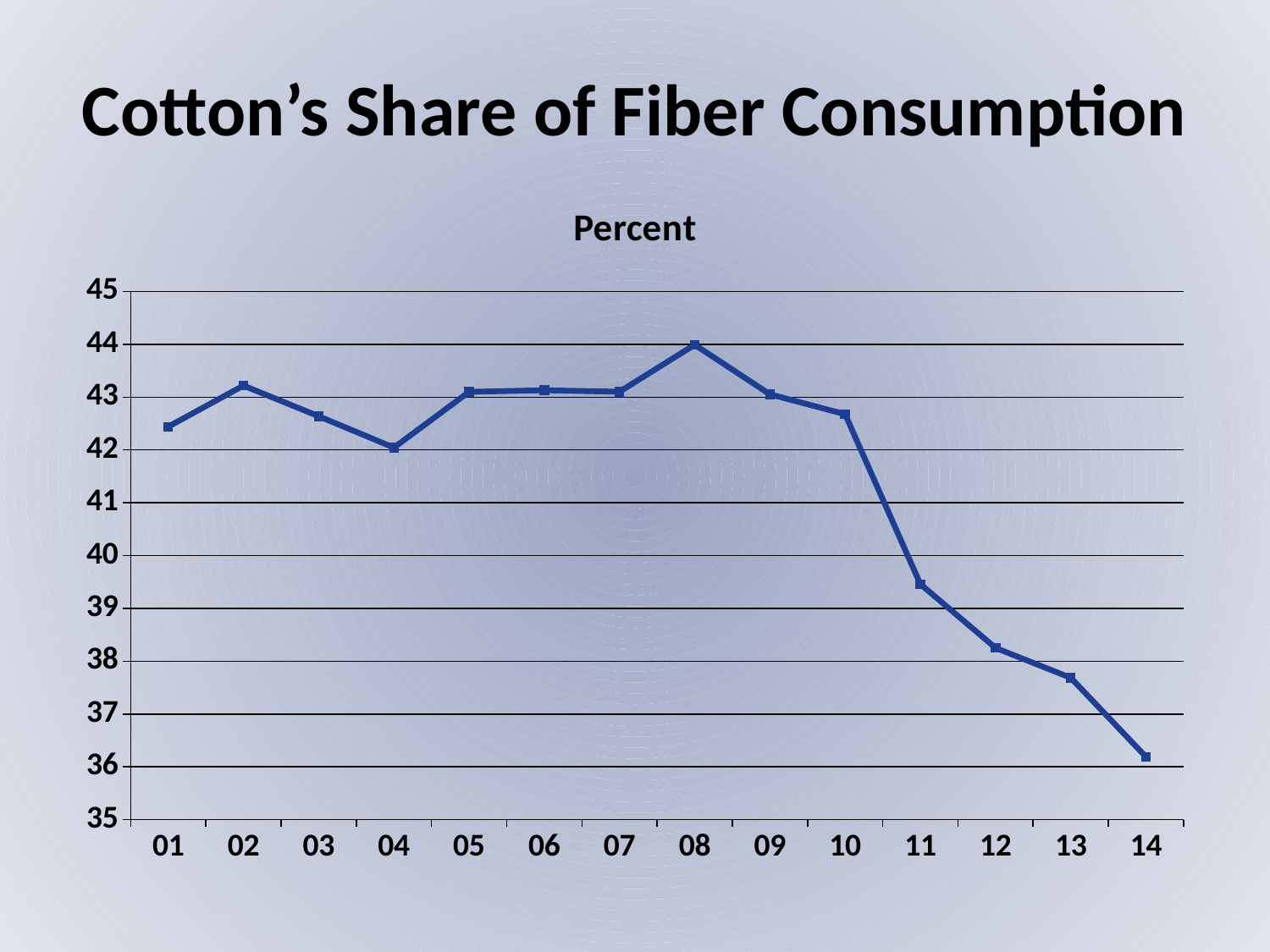
Which year has the larger value, 11 or 12? 11 Do the values rise or fall from 10 to 14? fall What unit label appears above the chart? Percent What kind of chart is shown on the slide? line chart Is the value for 04 greater or less than 41? greater How many years are plotted along the x axis? 14 Is the value for 08 greater or less than 43? greater In which year is cotton's share of fiber consumption lowest? 14 Is the value for 11 greater or less than 40? less In which year is cotton's share of fiber consumption highest? 08 What is the title of the slide? Cotton's Share of Fiber Consumption